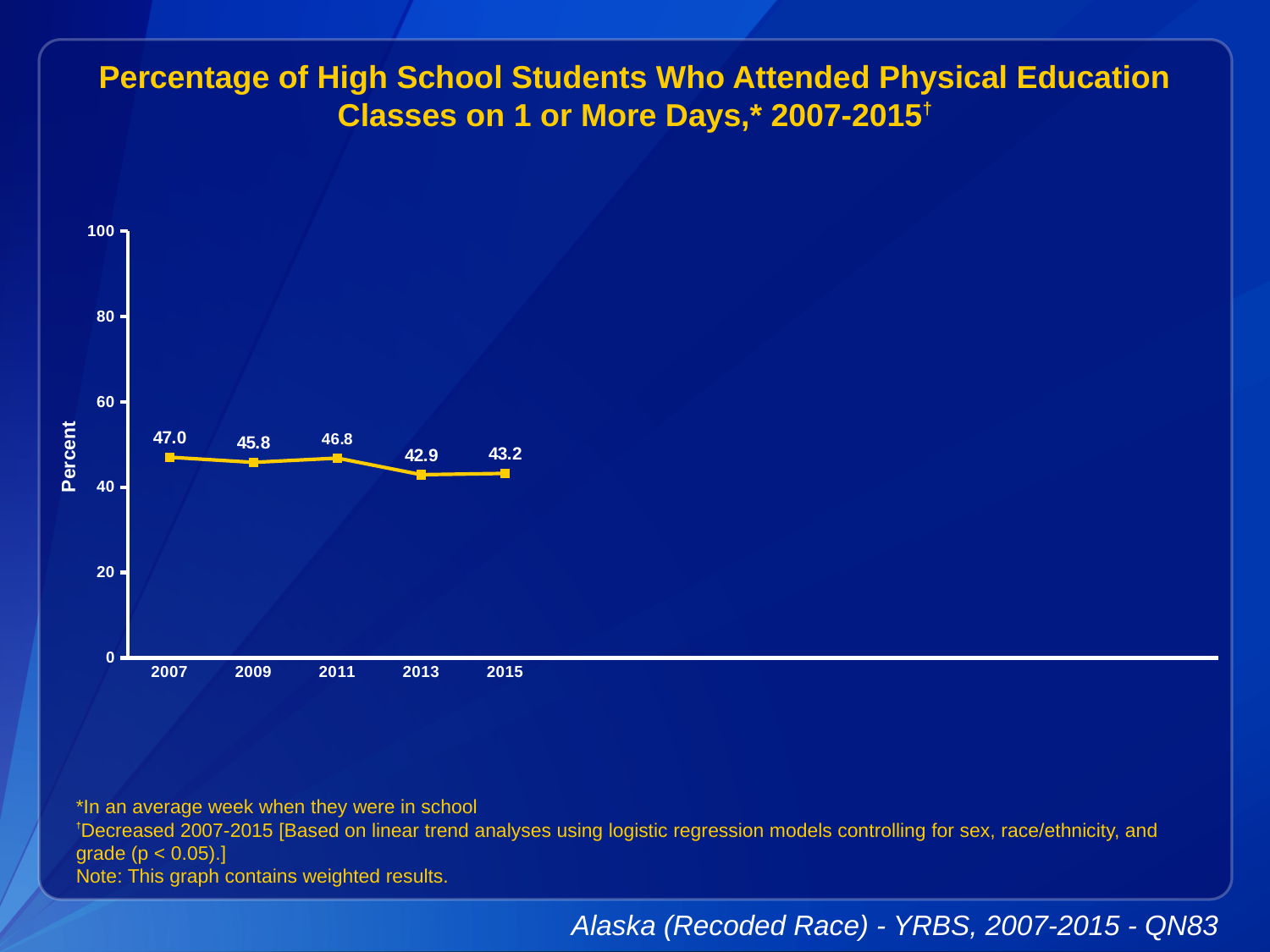
What kind of chart is shown on the slide? line chart Is the value for 2011 greater or less than 40? greater What percentage of high school students attended physical education classes on 1 or more days in 2007? 47.0 What is the value plotted for 2015? 43.2 What is the label on the vertical axis? Percent What is the value plotted for 2013? 42.9 Which year has the lowest percentage? 2013 What is the difference between the 2007 value and the 2015 value? 3.8 How many years are plotted on the chart? 5 Which year has the highest percentage? 2007 Overall, do the values rise or fall from 2007 to 2015? fall Which is larger, the value for 2009 or the value for 2011? 2011